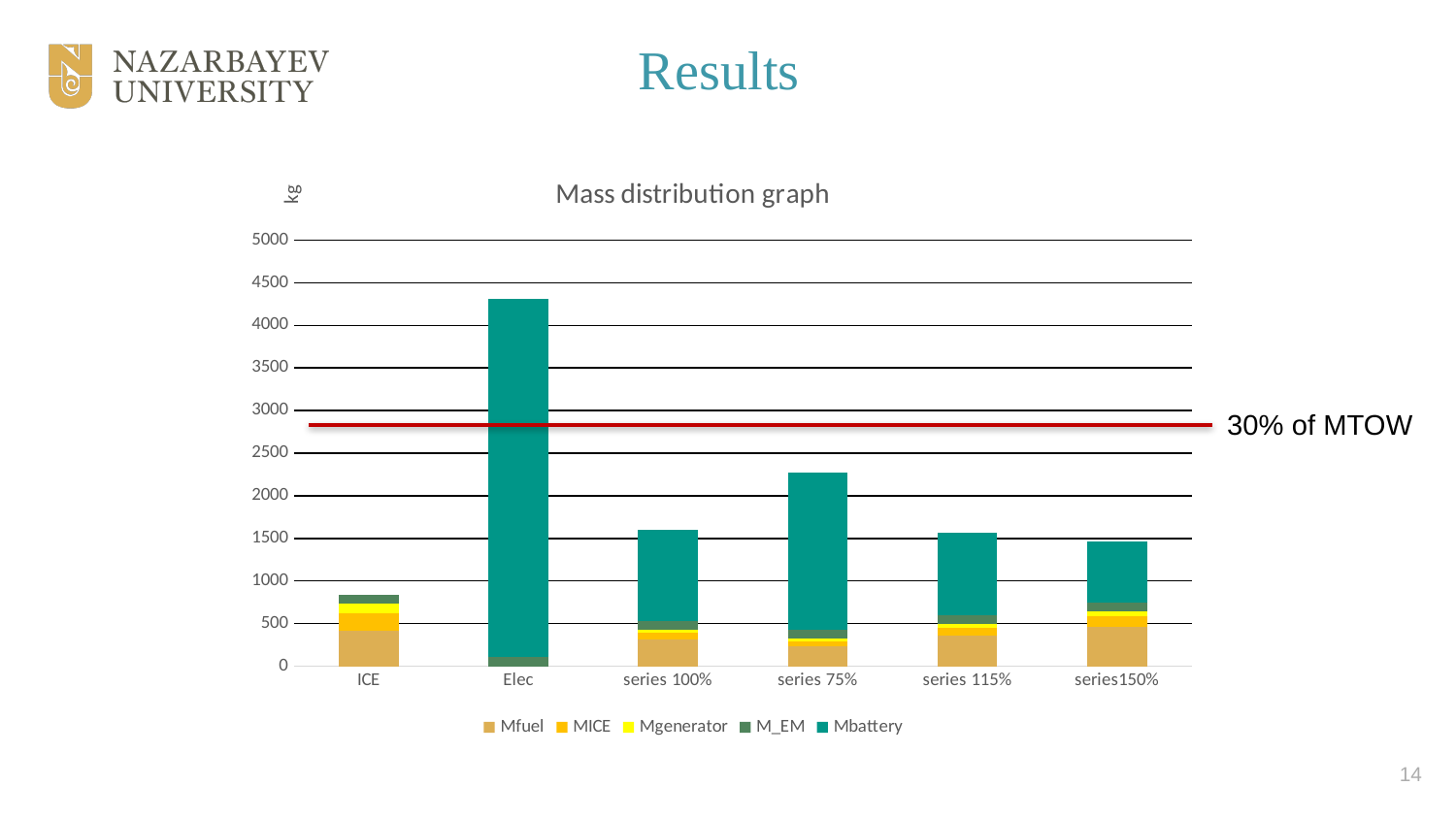
What does the red horizontal line on the chart represent? 30% of MTOW How many series does the chart legend list? 5 Is the total bar height for Elec greater or less than 4000? greater What type of chart is shown on the slide? Stacked bar chart Is the total bar height for series 115% greater or less than 2000? less Which has a taller stacked bar, series 75% or series 100%? series 75% What is the title of the chart? Mass distribution graph How many categories are shown on the x axis of the chart? 6 Is the total bar height for ICE greater or less than 1000? less Which category has the tallest stacked bar? Elec Which category has the shortest stacked bar? ICE